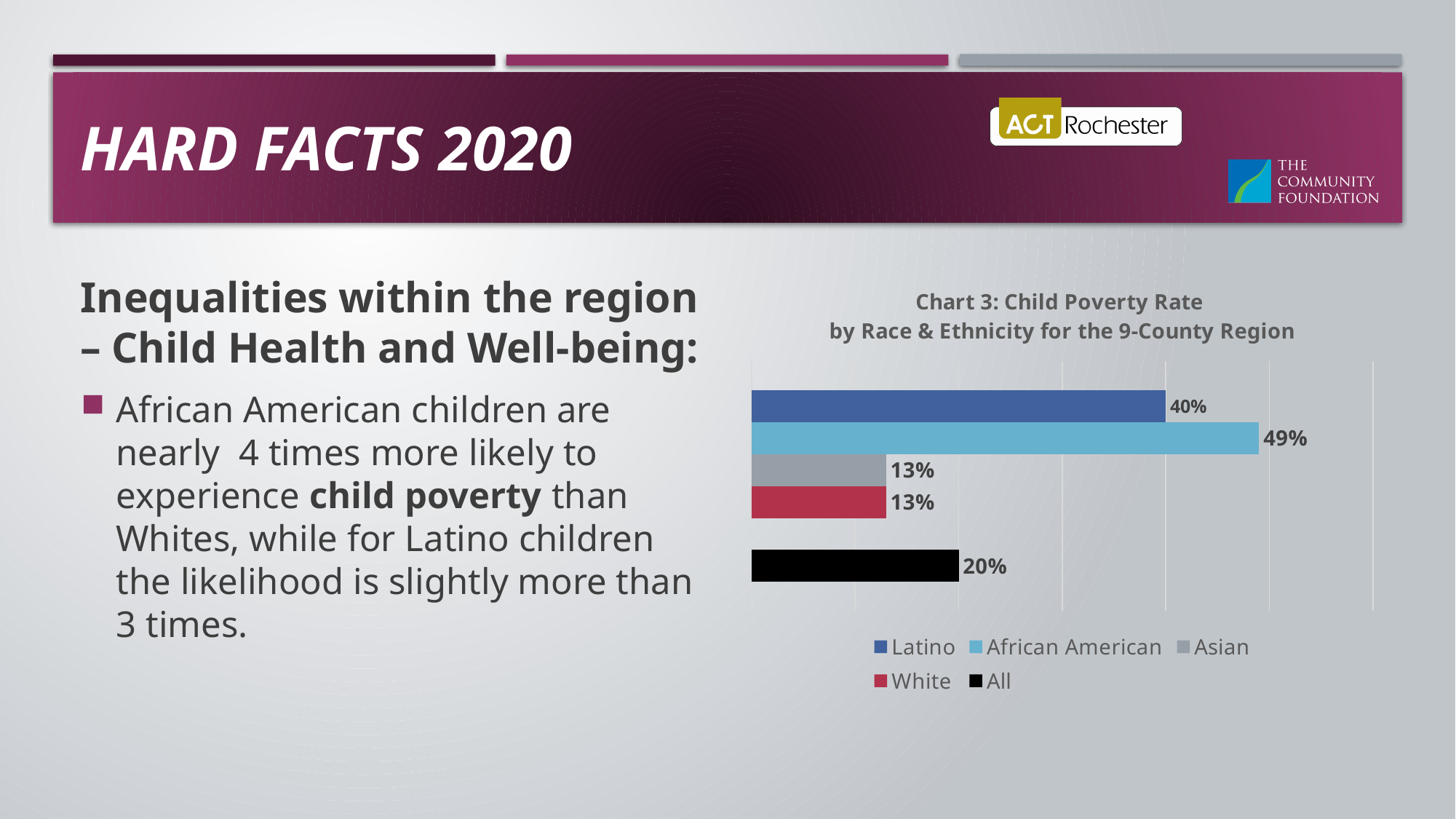
Which group has the highest child poverty rate? African American What kind of chart is shown? Bar chart What is the difference between the child poverty rate for Latino children and the rate for All children? 20% What is the child poverty rate for White children? 13% What is the title of the chart? Chart 3: Child Poverty Rate by Race & Ethnicity for the 9-County Region What is the difference between the child poverty rate for African American children and for White children? 36% Which is larger, the child poverty rate for Latino children or for Asian children? Latino What is the child poverty rate for Latino children? 40% How many series does the legend list? 5 What is the child poverty rate for All children? 20% What is the child poverty rate for African American children? 49% What colour is the bar for All children? Black